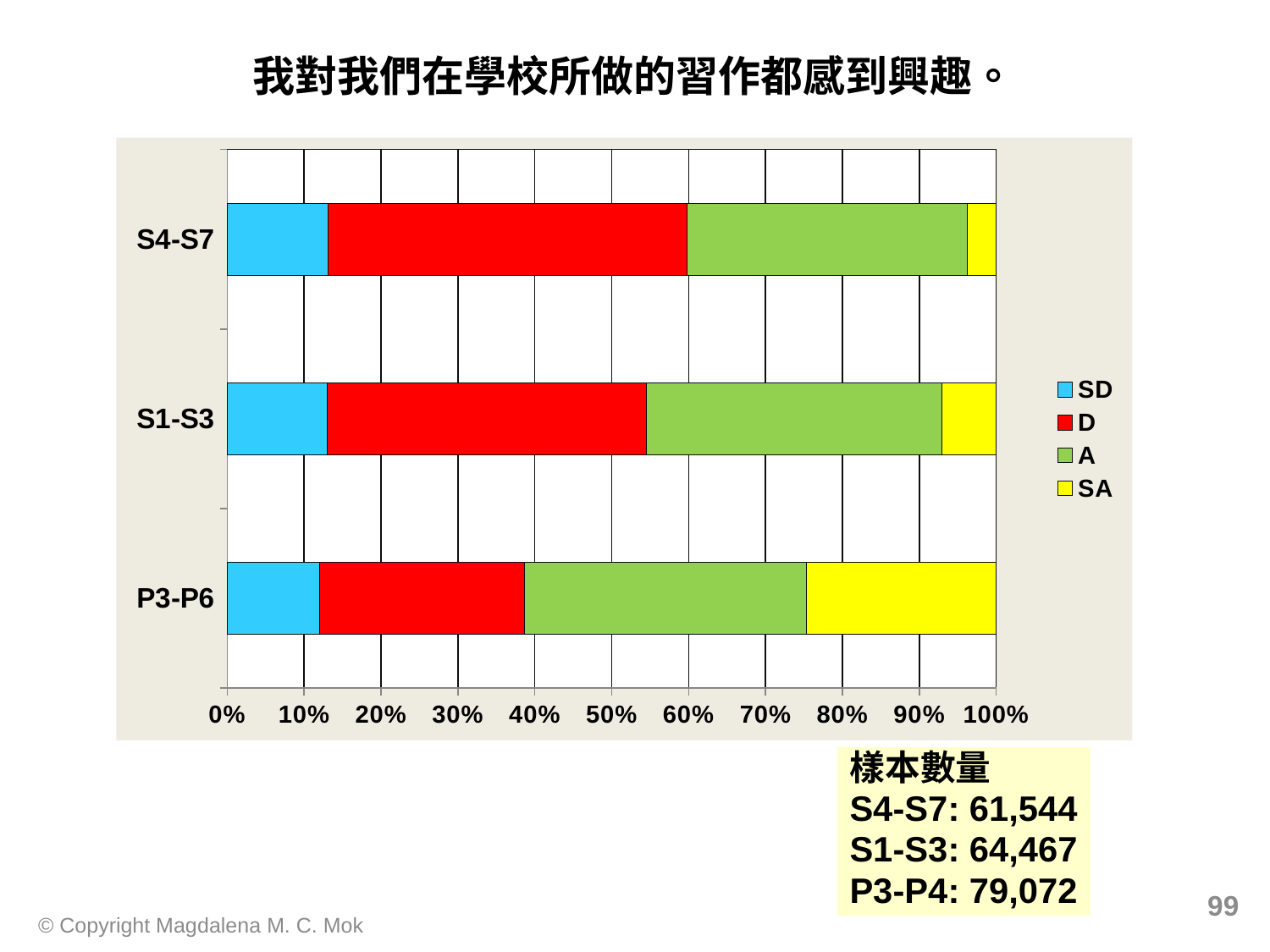
Is the SD value for S1-S3 greater or less than 10%? greater What is the total of the stacked bar for P3-P6? 100% Which category has the smallest SA (yellow) segment? S4-S7 Which category has the largest D (red) segment? S4-S7 What kind of chart is shown on the slide? stacked bar chart How many series does the legend list? 4 Is the SA value for S4-S7 greater or less than 10%? less How many categories (grade groups) are plotted on the chart? 3 Which category has the largest SA (yellow) segment? P3-P6 Which colour represents the series A in the legend? green Which is larger, the D segment for S4-S7 or the D segment for P3-P6? S4-S7 Is the SA value for P3-P6 greater or less than 20%? greater